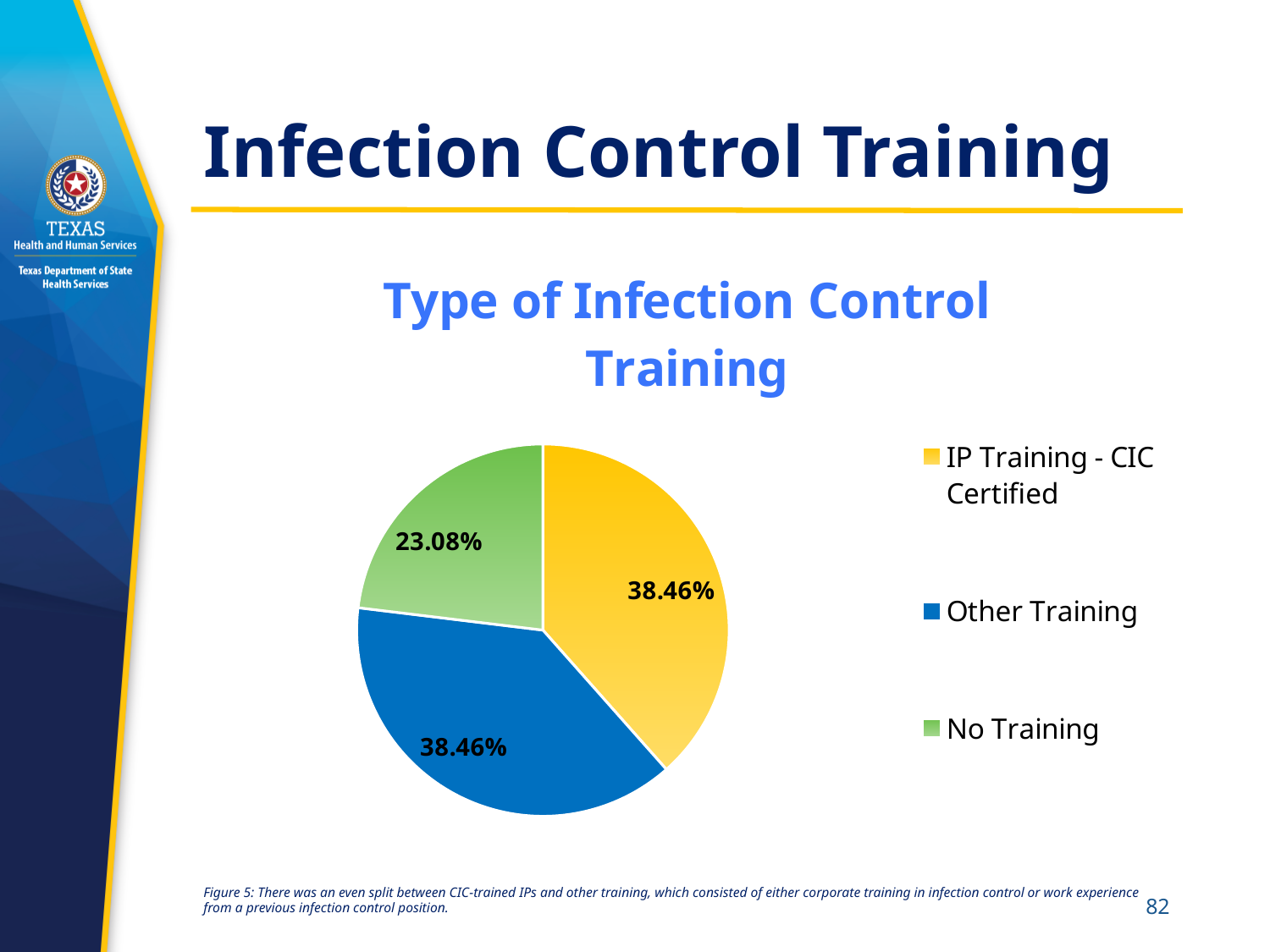
What share of the pie is labelled for Other Training? 38.46% What share of the pie is labelled for No Training? 23.08% Which category has the smallest slice of the pie? No Training What type of chart is shown on the slide? Pie chart Which colour represents No Training in the chart? Green What is the difference between the share for IP Training - CIC Certified and the share for No Training? 15.38% How many categories does the legend list? 3 What is the title of the chart? Type of Infection Control Training What is the combined share of IP Training - CIC Certified and Other Training? 76.92% What share of the pie is labelled for IP Training - CIC Certified? 38.46% Which is larger, the share for Other Training or the share for No Training? Other Training